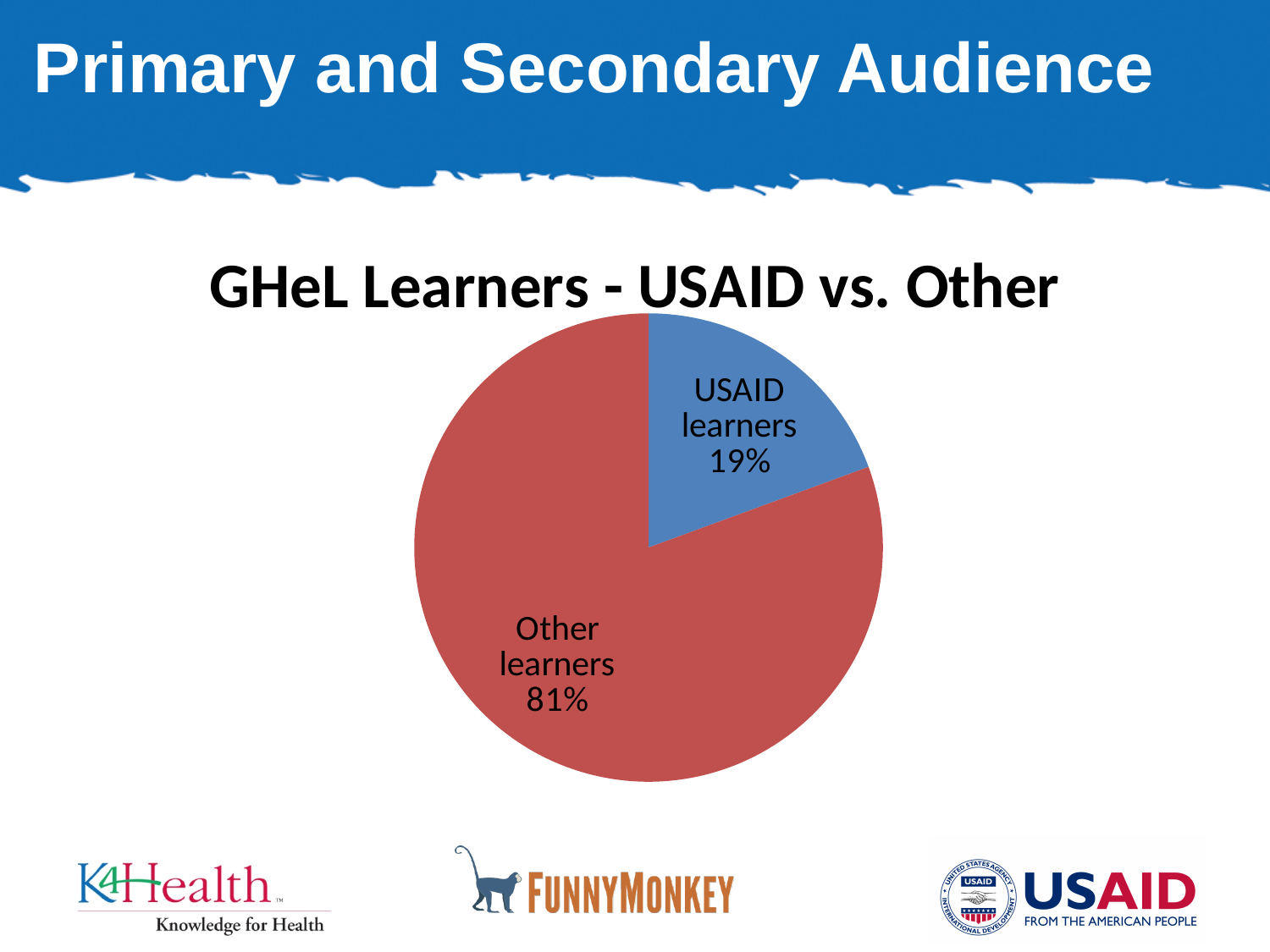
What is the difference in percentage points between Other learners and USAID learners? 62 What is the total of the two slices shown in the pie chart? 100% How many slices does the pie chart have? 2 Which is larger, the share for USAID learners or the share for Other learners? Other learners What is the title of the chart? GHeL Learners - USAID vs. Other What share of the pie do USAID learners represent? 19% Which slice of the pie is the largest? Other learners Which slice of the pie is the smallest? USAID learners What type of chart is shown on the slide? pie chart What colour is the USAID learners slice? blue What share of the pie do Other learners represent? 81%